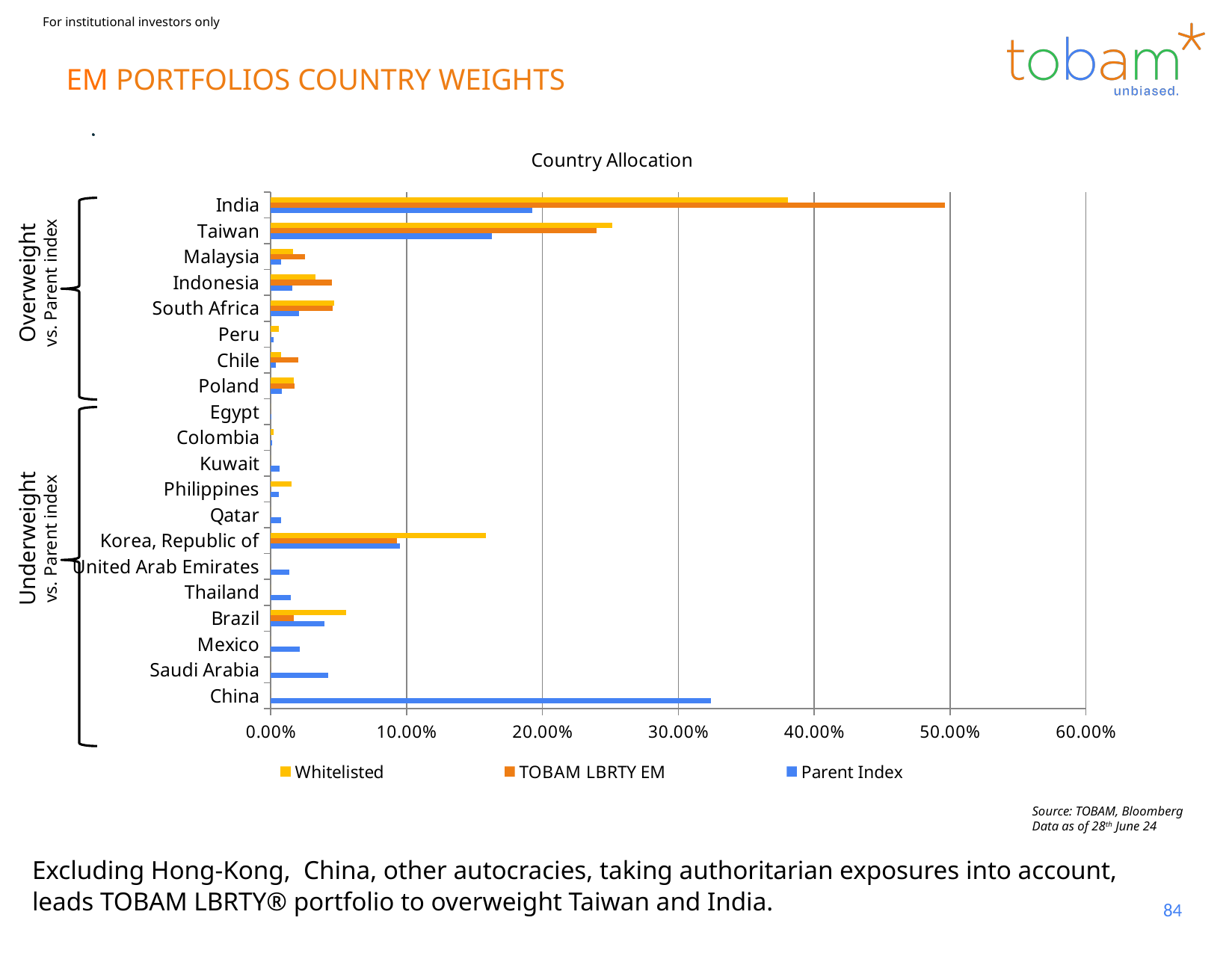
Which country has the highest TOBAM LBRTY EM weight? India What kind of chart is shown on the slide? bar chart Which country has the highest Parent Index weight? China Is the Whitelisted value for Korea, Republic of greater or less than 10.00%? greater How many countries are plotted on the chart? 20 Which country has the highest Whitelisted weight? India For China, which is larger: the Parent Index value or the TOBAM LBRTY EM value? Parent Index What is the title of the chart? Country Allocation Is the TOBAM LBRTY EM value for India greater or less than 40.00%? greater How many series does the legend list? 3 Which colour represents the Parent Index series in the legend? blue Is the Parent Index value for China greater or less than 30.00%? greater